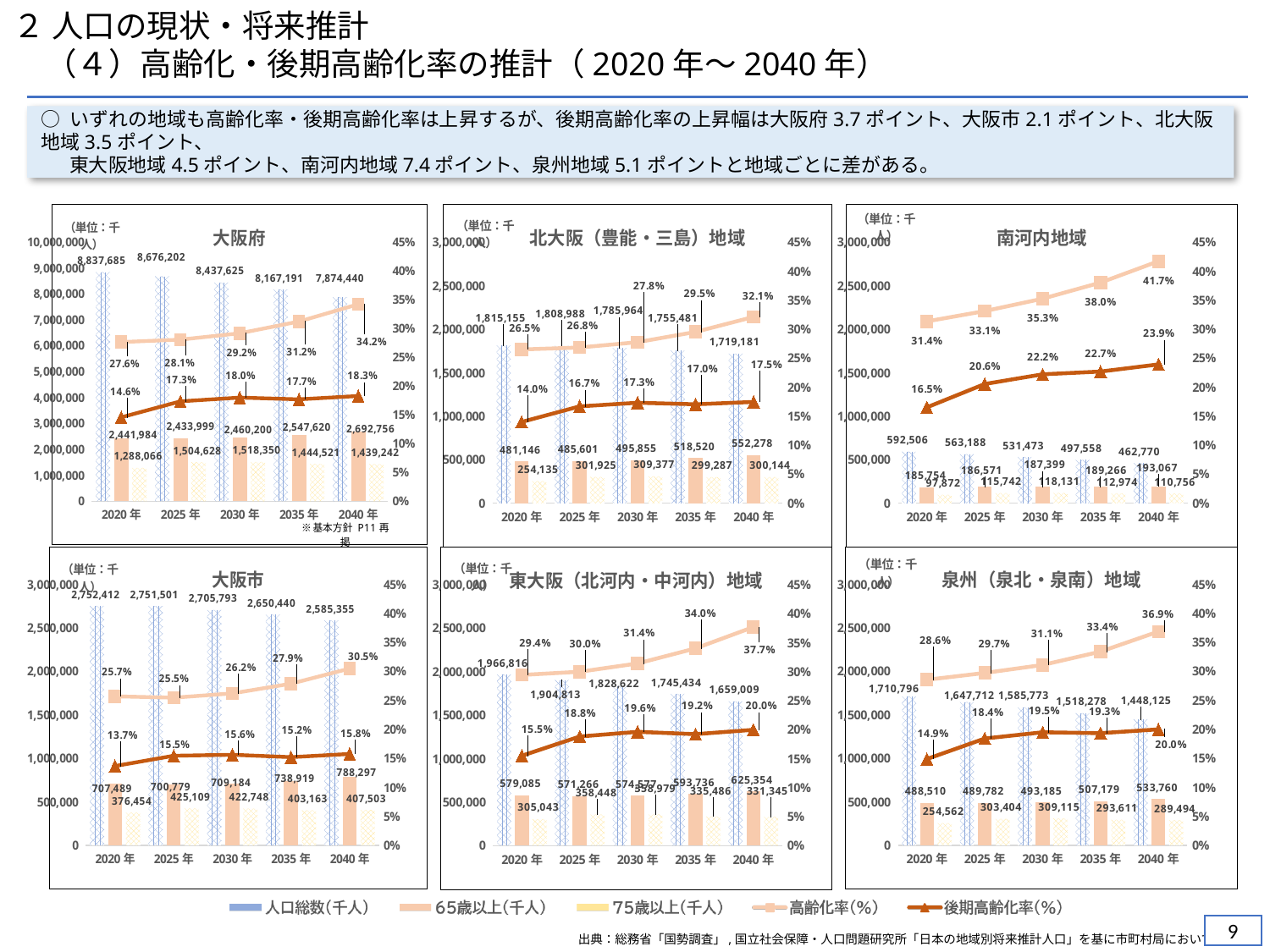
In the 大阪府 chart, what is the 高齢化率(%) value for 2040年? 34.2% In the 泉州（泉北・泉南）地域 chart, does the 人口総数(千人) rise or fall from 2020年 to 2040年? fall In the 大阪市 chart, what is the 65歳以上(千人) value for 2040年? 788,297 In the 南河内地域 chart, what is the 後期高齢化率(%) value for 2040年? 23.9% In the 東大阪（北河内・中河内）地域 chart, what is the 人口総数(千人) value for 2020年? 1,966,816 In the 南河内地域 chart, which year has the highest 高齢化率(%)? 2040年 In the 大阪府 chart, what is the 人口総数(千人) value for 2020年? 8,837,685 How many charts are shown on the slide? 6 In the 北大阪（豊能・三島）地域 chart, what is the difference in 高齢化率(%) between 2040年 and 2020年? 5.6 percentage points How many series does the legend at the bottom of the slide list? 5 In the 泉州（泉北・泉南）地域 chart, which is larger, the 75歳以上(千人) value for 2030年 or for 2040年? 2030年 In the 大阪市 chart, which year has the lowest 後期高齢化率(%)? 2020年